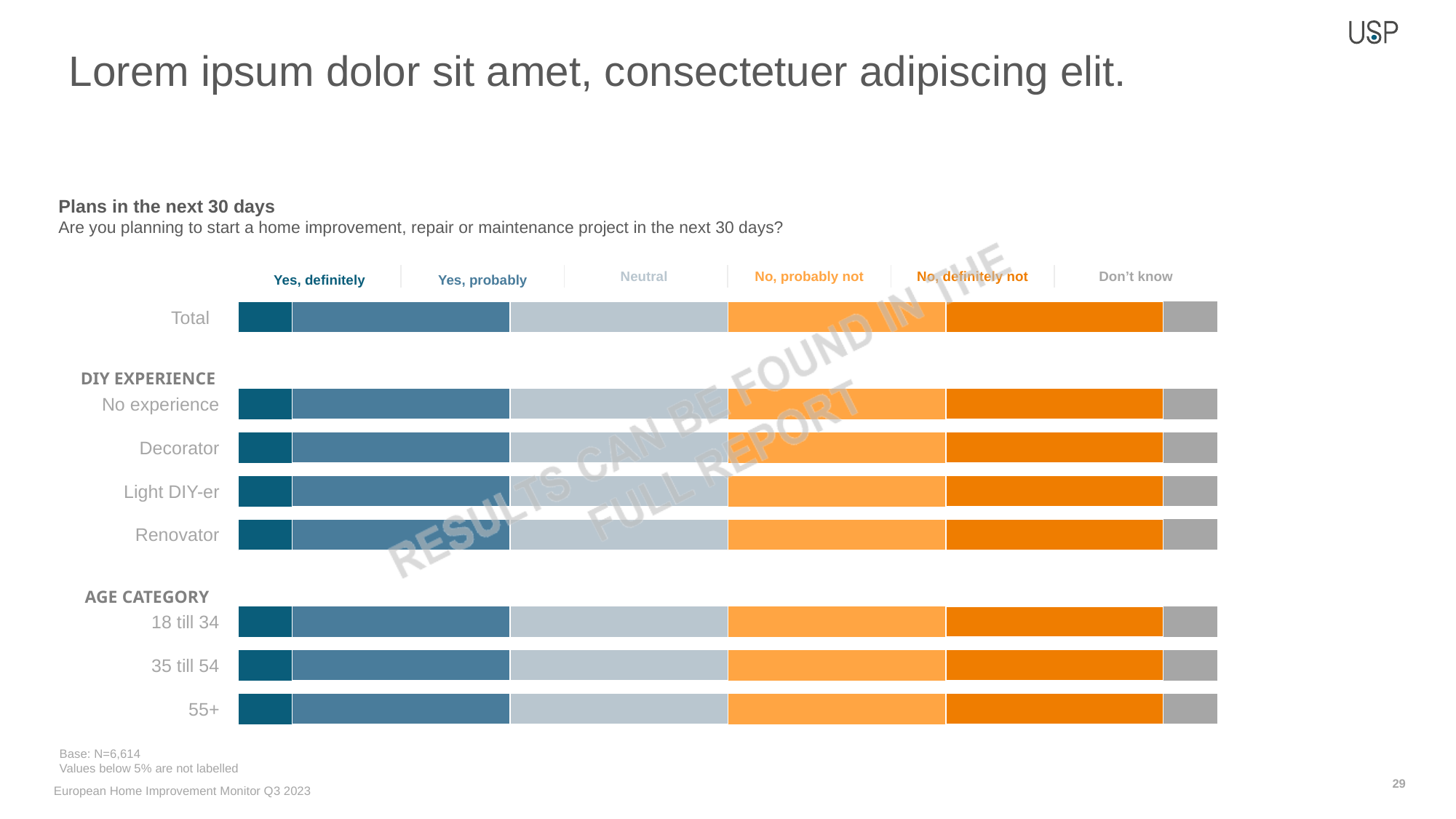
In the Renovator bar, which segment is wider: 'No, definitely not' or 'Don't know'? No, definitely not What is the title of the chart? Plans in the next 30 days How many response options does the legend of the chart list? 6 How many categories are listed under the DIY EXPERIENCE group? 4 What is the base (sample size) stated below the chart? N=6,614 How many bars (rows) are plotted in the chart? 8 What kind of chart is shown on the slide? Stacked bar chart Which response option is shown in the darkest blue colour in the chart? Yes, definitely In the Total bar, which segment is wider: 'Yes, definitely' or 'Yes, probably'? Yes, probably In the Total bar, which segment is wider: 'Don't know' or 'Neutral'? Neutral How many categories are listed under the AGE CATEGORY group? 3